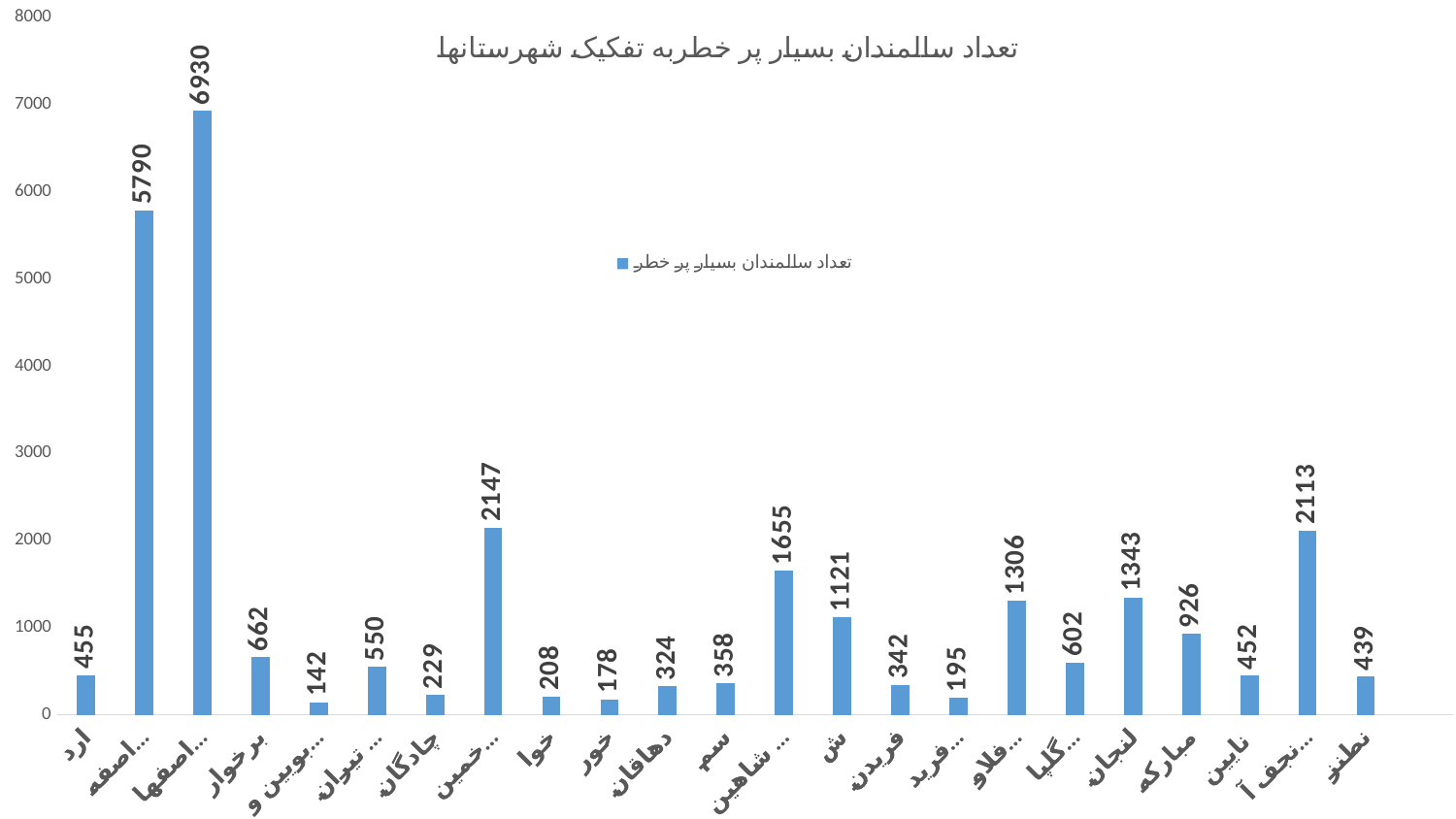
Is the value for فریدن greater or less than 1000? less What is the value shown on the tallest bar in the chart? 6930 How many bars (categories) are plotted in the chart? 23 What is the value shown on the shortest bar in the chart? 142 What type of chart is shown on the slide? bar chart Which has a larger value, چادگان or دهاقان? دهاقان What is the difference between the values for لنجان and مبارکه? 417 What is the value for مبارکه? 926 How many series does the legend list? 1 What is the value for لنجان? 1343 What is the value for نطنز? 439 What is the value for برخوار? 662